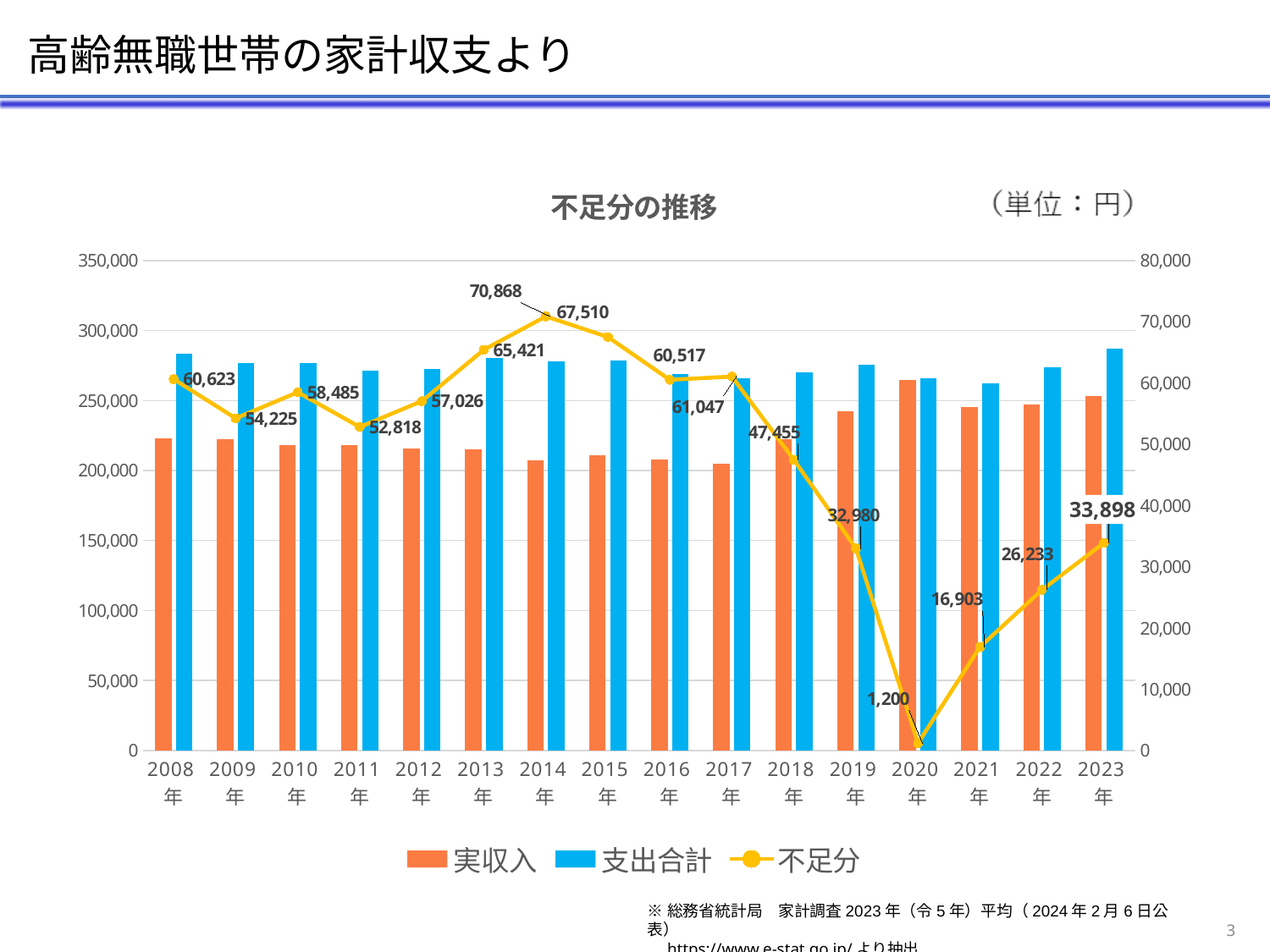
What is the value of 不足分 for 2020年? 1,200 Which is larger, 不足分 in 2019年 or in 2022年? 2019年 What is the difference between 不足分 in 2014年 and 2015年? 3,358 How many years are shown on the x axis? 16 Is the value of 支出合計 for 2023年 greater or less than 300,000? less What is the value of 不足分 for 2014年? 70,868 In which year is 不足分 lowest? 2020年 Does 不足分 rise or fall from 2017年 to 2020年? fall How many series does the legend list? 3 In which year is 不足分 highest? 2014年 Is the value of 実収入 for 2008年 greater or less than 200,000? greater What is the value of 不足分 for 2023年? 33,898